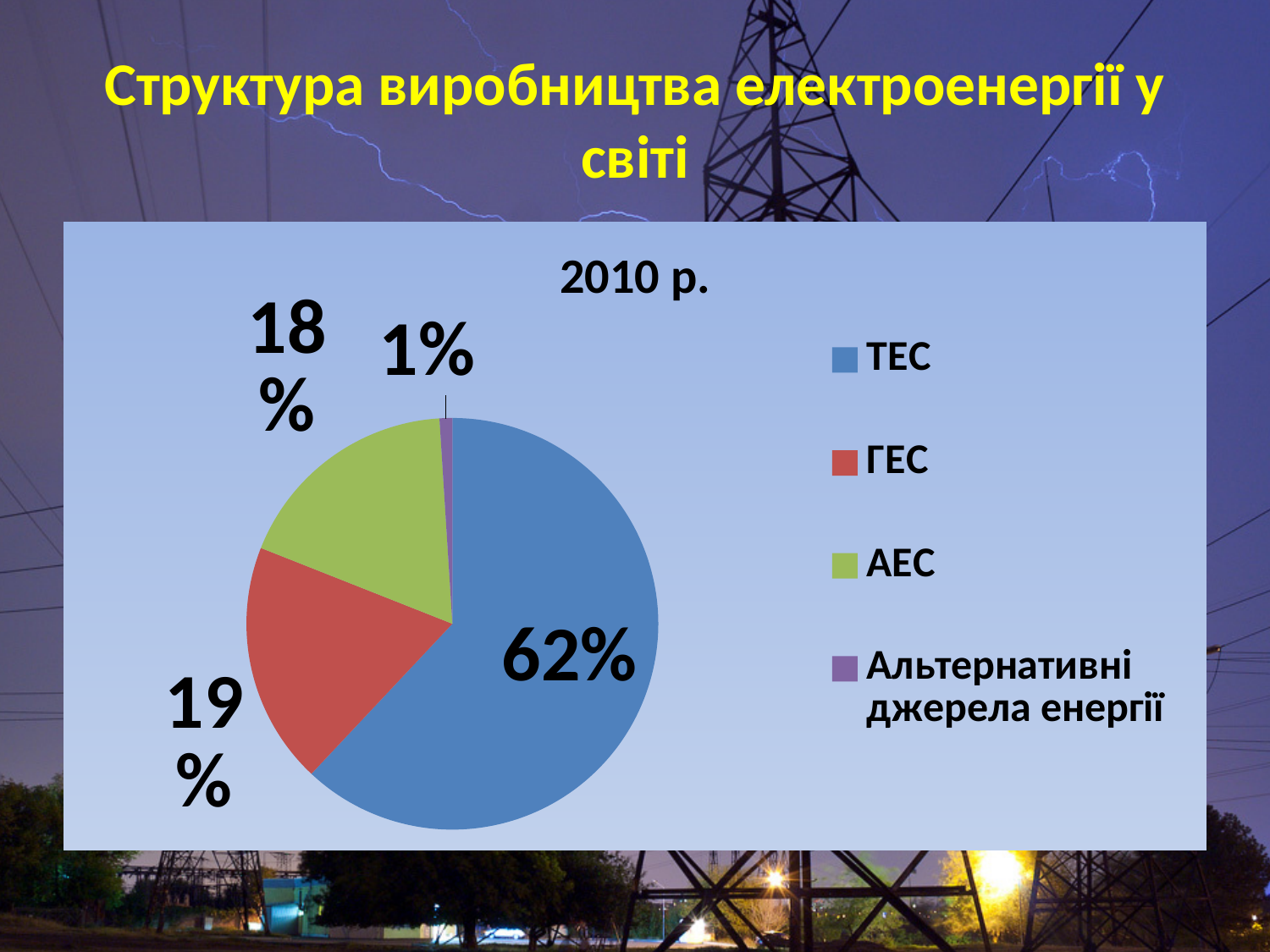
Which category has the largest slice of the pie? ТЕС What share of the pie do Альтернативні джерела енергії have? 1% Which is larger, the ТЕС slice or the АЕС slice? ТЕС What is the difference in percentage points between the ТЕС slice and the ГЕС slice? 43 What share of the pie does ГЕС have? 19% How many categories are shown in the pie chart? 4 What kind of chart is shown on the slide? Pie chart What share of the pie does АЕС have? 18% Which category has the smallest slice of the pie? Альтернативні джерела енергії What is the title of the chart? 2010 р. What is the difference in percentage points between the ГЕС slice and the АЕС slice? 1